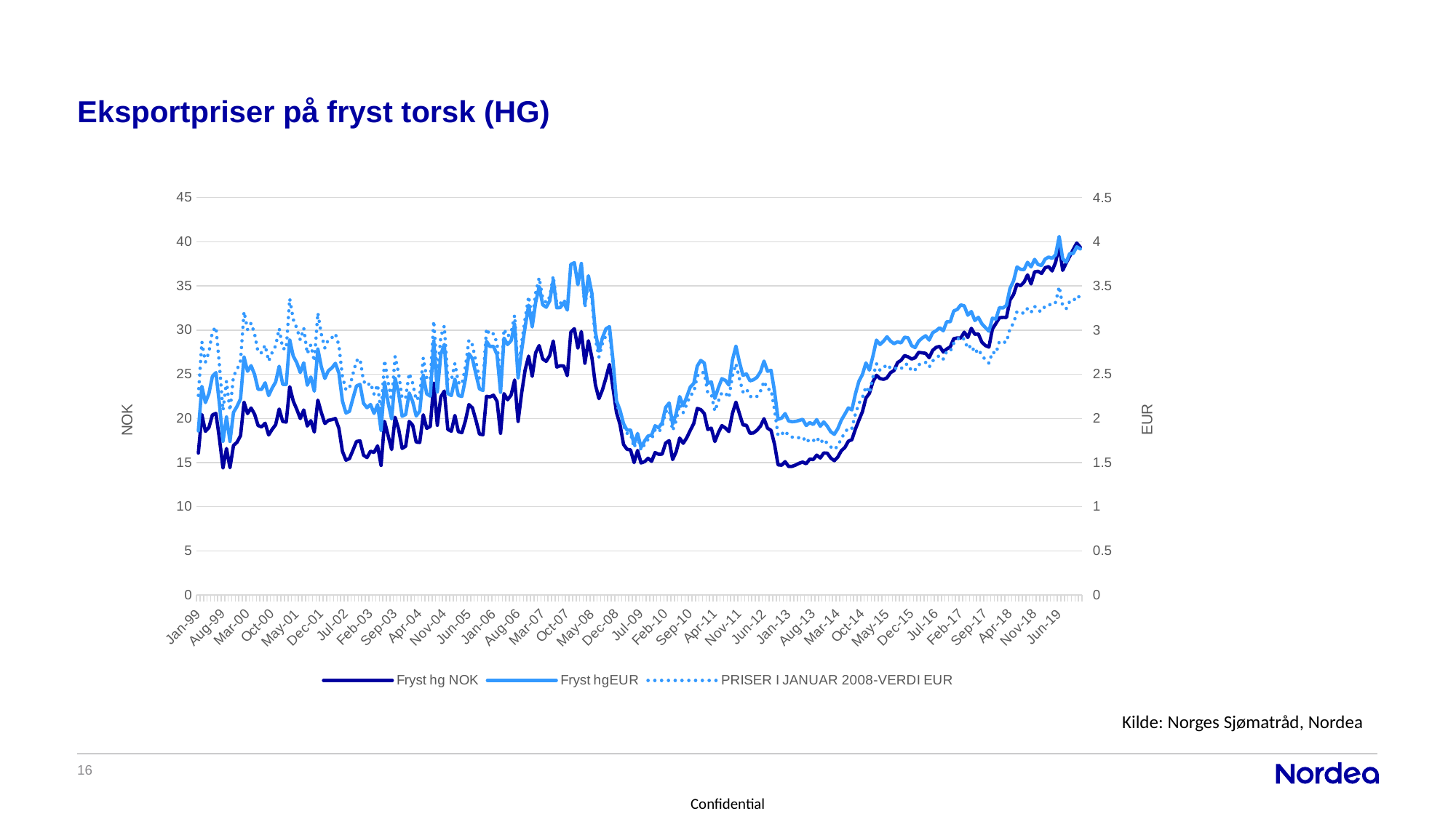
What is the label on the left vertical axis? NOK What is the title of the chart? Eksportpriser på fryst torsk (HG) How many series does the legend list? 3 Is the value of Fryst hgEUR at Jun-19 greater or less than 3.5 on the EUR axis? greater Is the value of Fryst hg NOK at Jan-99 greater or less than 20? less Is the value of Fryst hg NOK at Jun-19 greater or less than 35? greater Does the Fryst hg NOK series rise or fall overall from Jan-99 to Jun-19? rise Does the Fryst hg NOK series rise or fall between Mar-14 and Apr-18? rise Does the Fryst hgEUR series rise or fall between Oct-07 and Jul-09? fall What kind of chart is shown on the slide? line chart